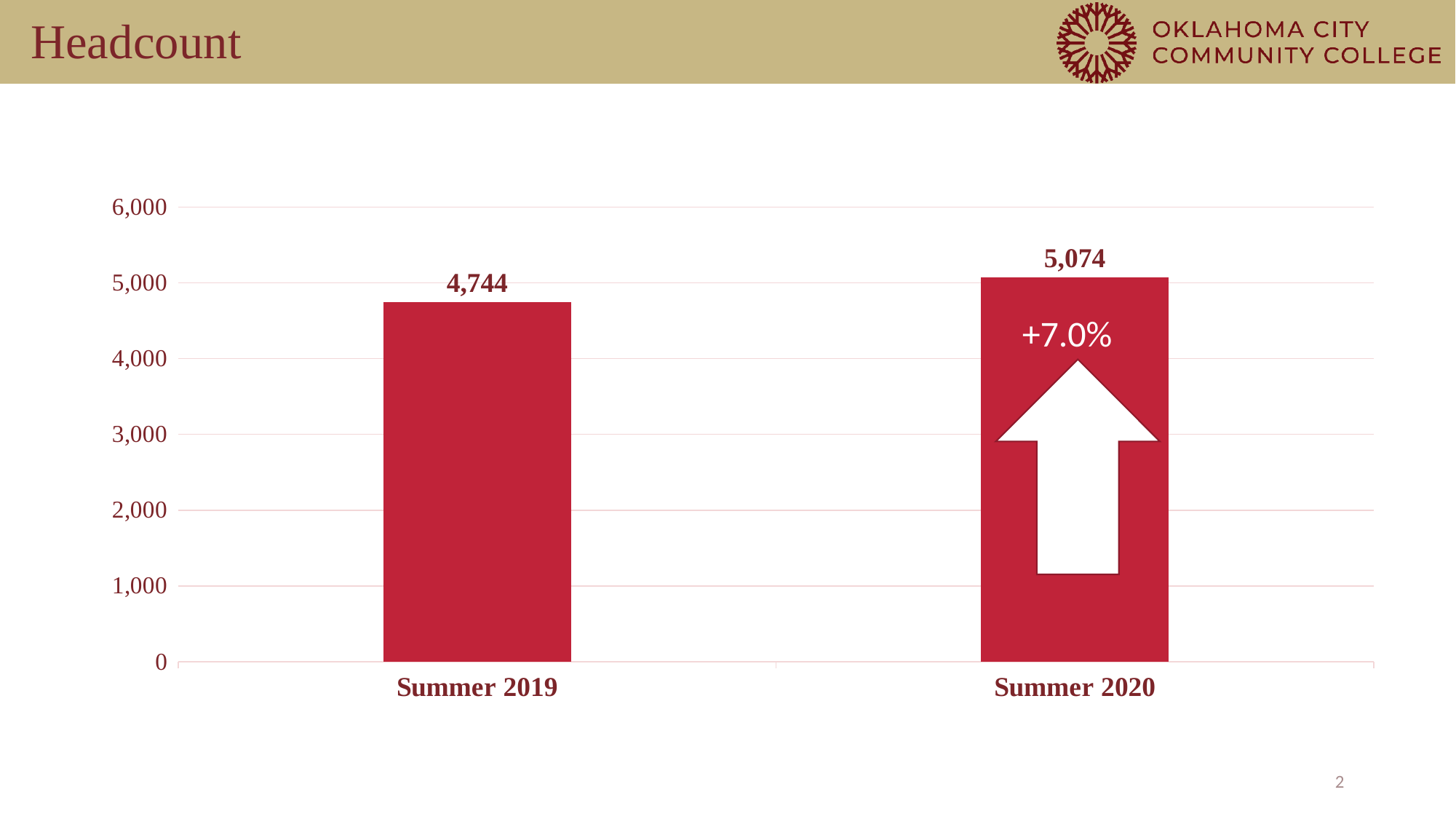
What is the headcount for Summer 2019? 4,744 What is the headcount for Summer 2020? 5,074 Is the value for Summer 2020 greater or less than 5,000? greater Do the values rise or fall from Summer 2019 to Summer 2020? rise Is the value for Summer 2019 greater or less than 5,000? less What kind of chart is shown on the slide? bar chart Which period has the higher headcount? Summer 2020 Which period has the lower headcount? Summer 2019 What is the difference in headcount between Summer 2020 and Summer 2019? 330 How many categories are shown on the x axis? 2 What percentage change is printed on the Summer 2020 bar? +7.0% Is the headcount for Summer 2019 larger or smaller than the headcount for Summer 2020? smaller